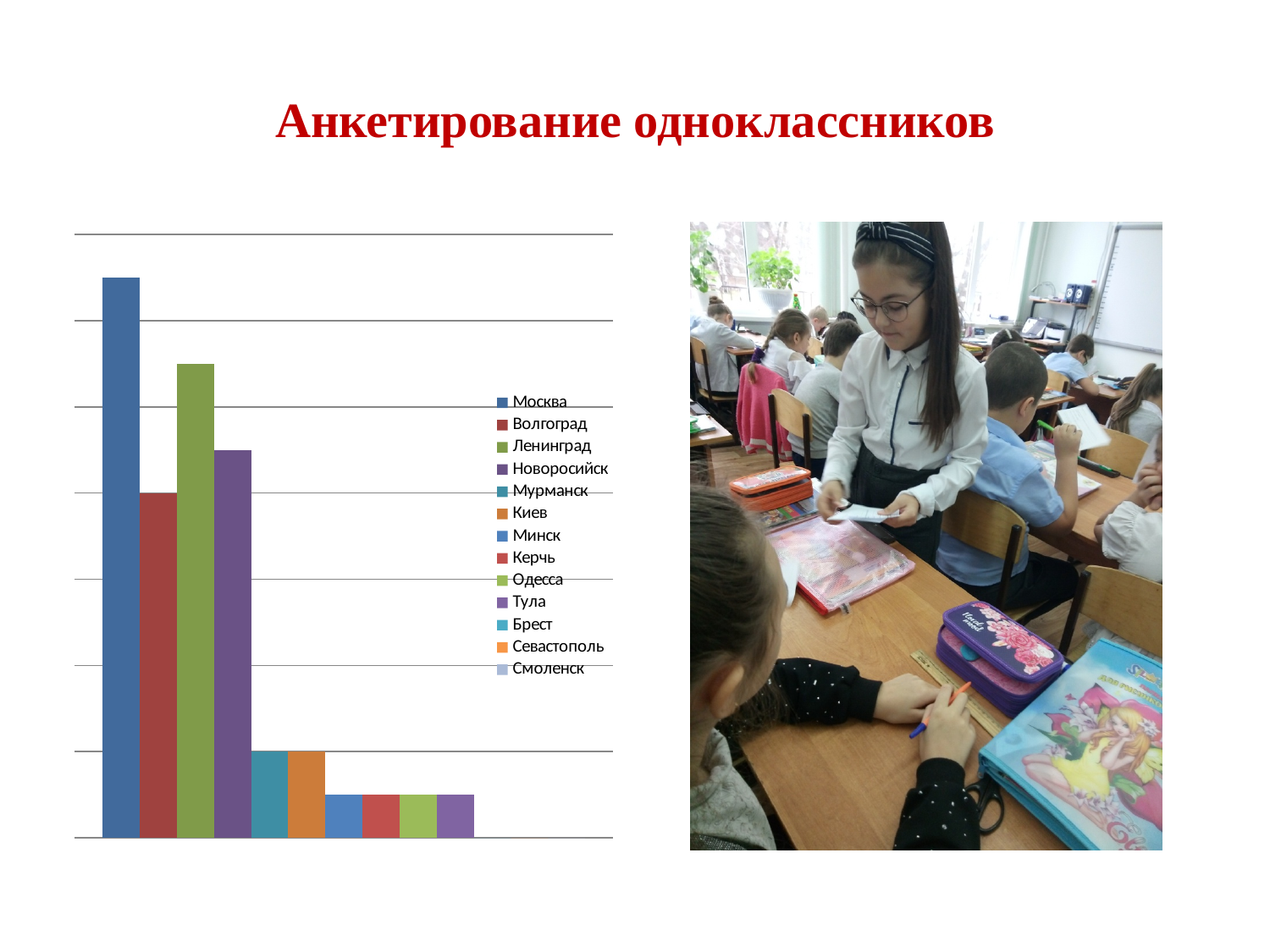
Which city has the highest bar in the chart? Москва Which city has the second highest bar in the chart? Ленинград What kind of chart is shown on the slide? bar chart What is the title of the slide containing the chart? Анкетирование одноклассников Do the bar heights generally rise or fall from left to right across the chart? fall Which bar is taller, Ленинград or Волгоград? Ленинград What colour is the bar for Москва? blue Which bar is taller, Москва or Новоросийск? Москва How many entries does the chart legend list? 13 Which bar is taller, Новоросийск or Волгоград? Новоросийск